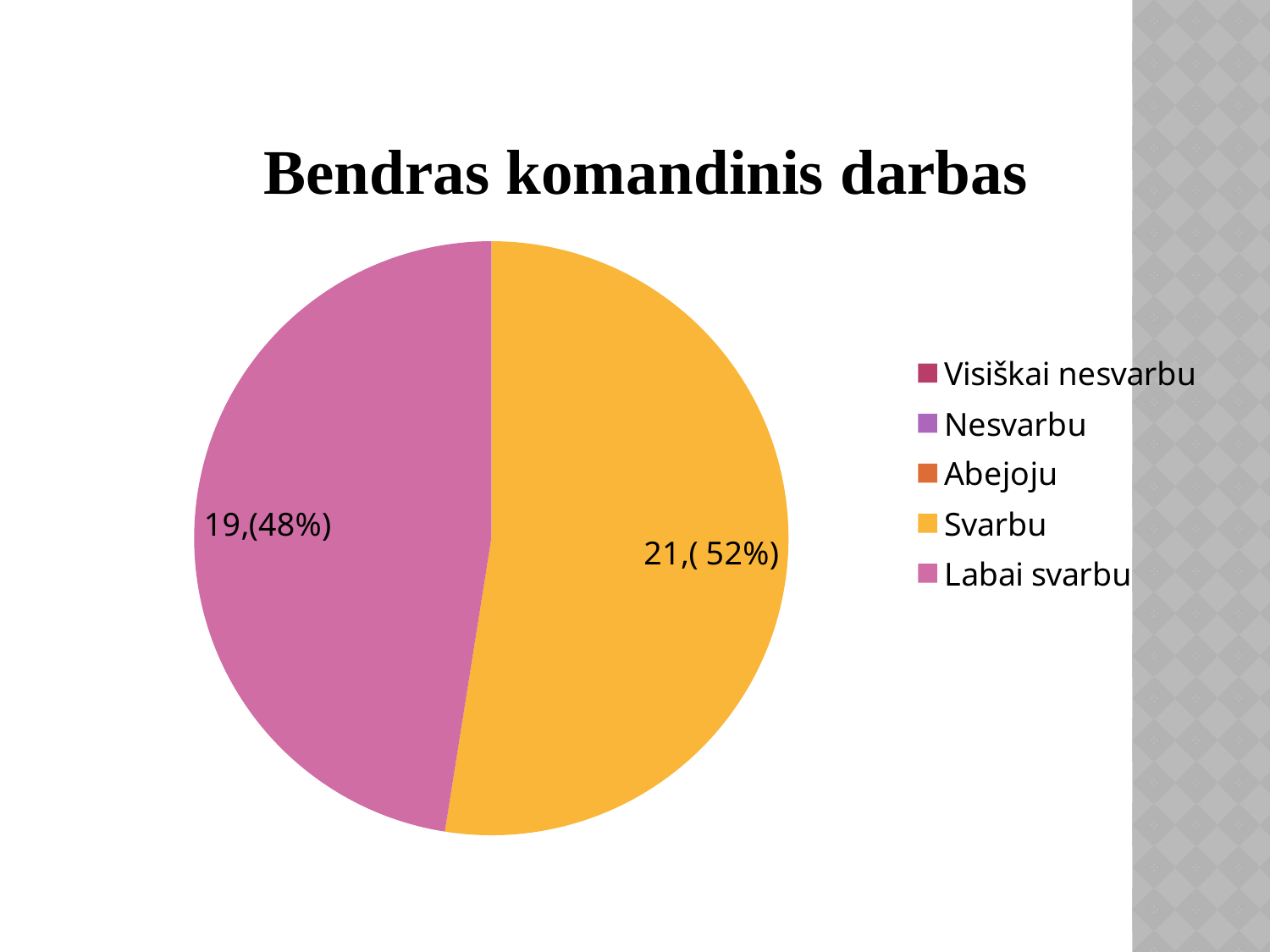
What is the difference between the counts for Svarbu and Labai svarbu? 2 What count is shown for the Labai svarbu slice? 19 How many entries does the legend list? 5 Which category has the largest slice in the pie chart? Svarbu What percentage share of the pie does the Svarbu slice have? 52% Which is larger, the count for Svarbu or the count for Labai svarbu? Svarbu What percentage share of the pie does the Labai svarbu slice have? 48% How many slices are visible in the pie chart? 2 What colour is the Svarbu slice in the pie chart? yellow What count is shown for the Svarbu slice? 21 What is the title of the chart? Bendras komandinis darbas What type of chart is shown on the slide? pie chart